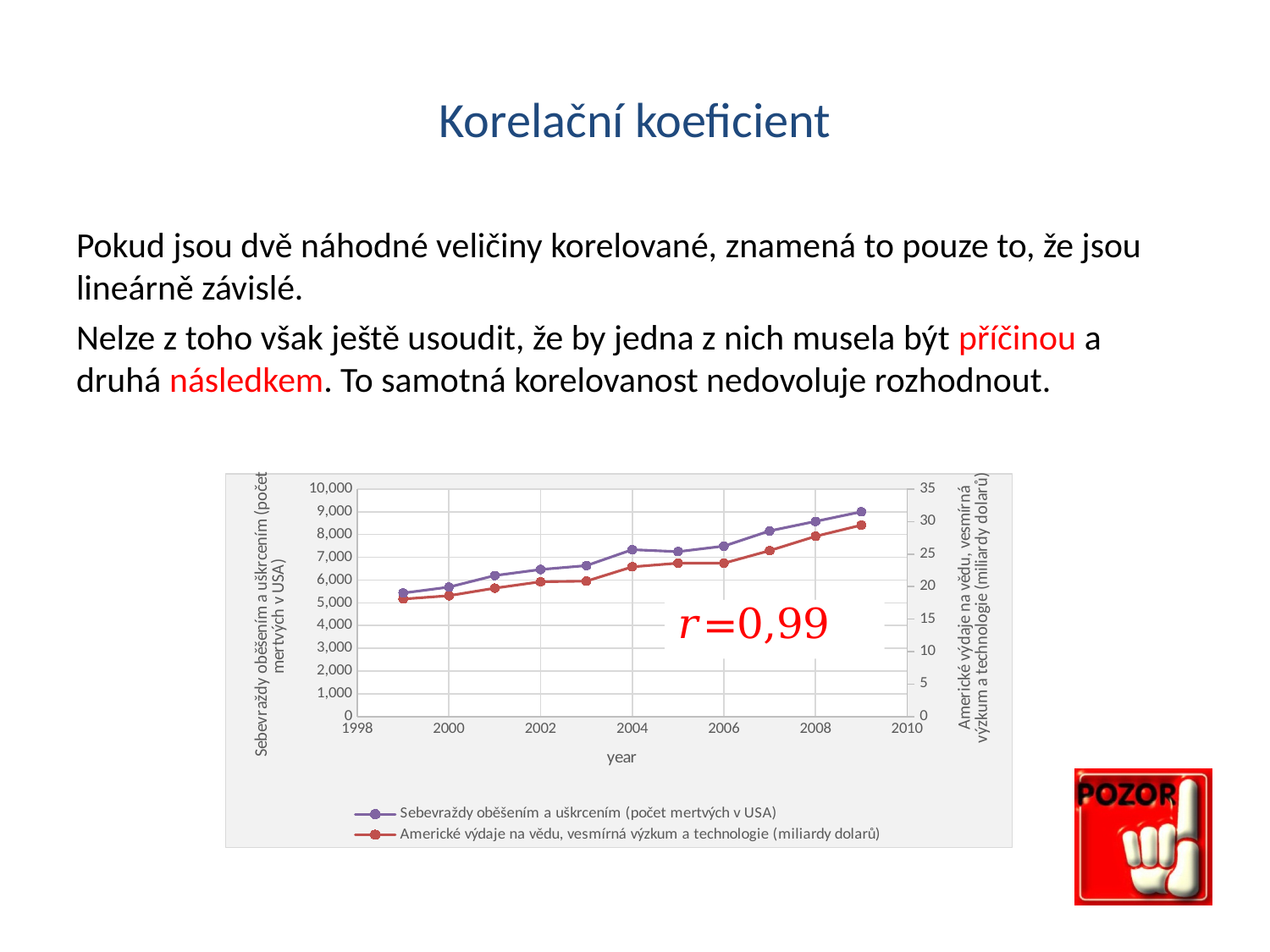
How many series does the chart's legend list? 2 What is the title of the x axis of the chart? year What correlation coefficient value is printed on the chart? r=0,99 In which year is the value of the American science spending series (Americké výdaje na vědu) highest? 2009 Is the value of the suicides series in 2008 greater or less than 8,000? greater What kind of chart is shown on the slide? line chart Do the values of the suicides series (Sebevraždy oběšením a uškrcením) rise or fall from 1999 to 2009? rise How many data points does each series in the chart have? 11 Is the value of the American science spending series in 1999 greater or less than 20 on the right axis? less Is the value of the American science spending series in 2009 greater or less than 25 on the right axis? greater In which year is the value of the suicides series (Sebevraždy oběšením a uškrcením) lowest? 1999